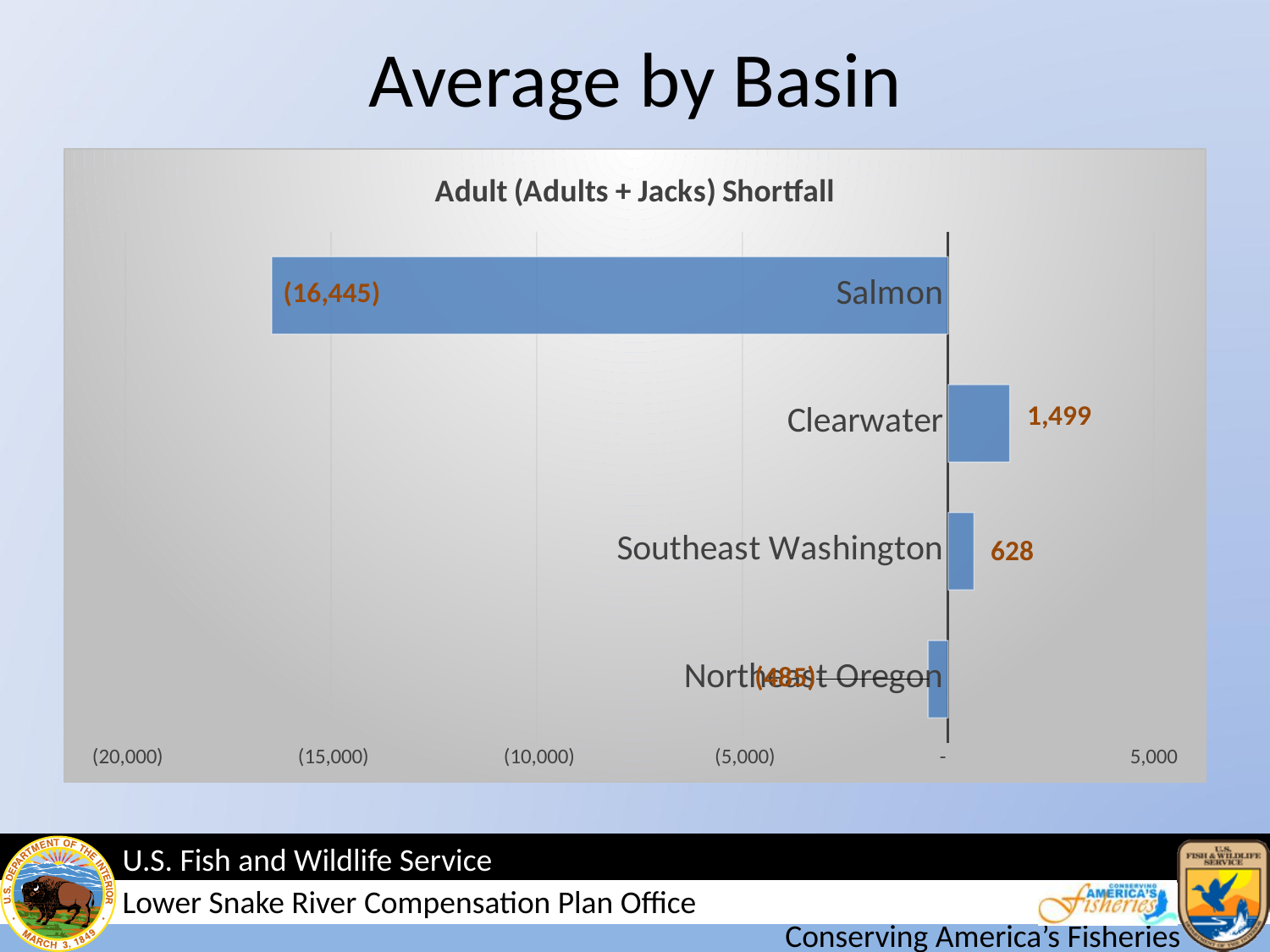
Which is larger, the value for Clearwater or the value for Southeast Washington? Clearwater What is the value for Southeast Washington? 628 What is the value for Salmon in the Adult (Adults + Jacks) Shortfall chart? (16,445) What is the title of the chart? Adult (Adults + Jacks) Shortfall Which basin's bar extends to the left of the zero line the farthest? Salmon Which basin has the lowest value in the chart? Salmon What is the value for Clearwater? 1,499 Which basin has the highest value in the chart? Clearwater How many basins are shown in the chart? 4 Is the value for Salmon greater or less than (15,000)? less What is the difference between the values for Clearwater and Southeast Washington? 871 What kind of chart is shown on the slide? bar chart